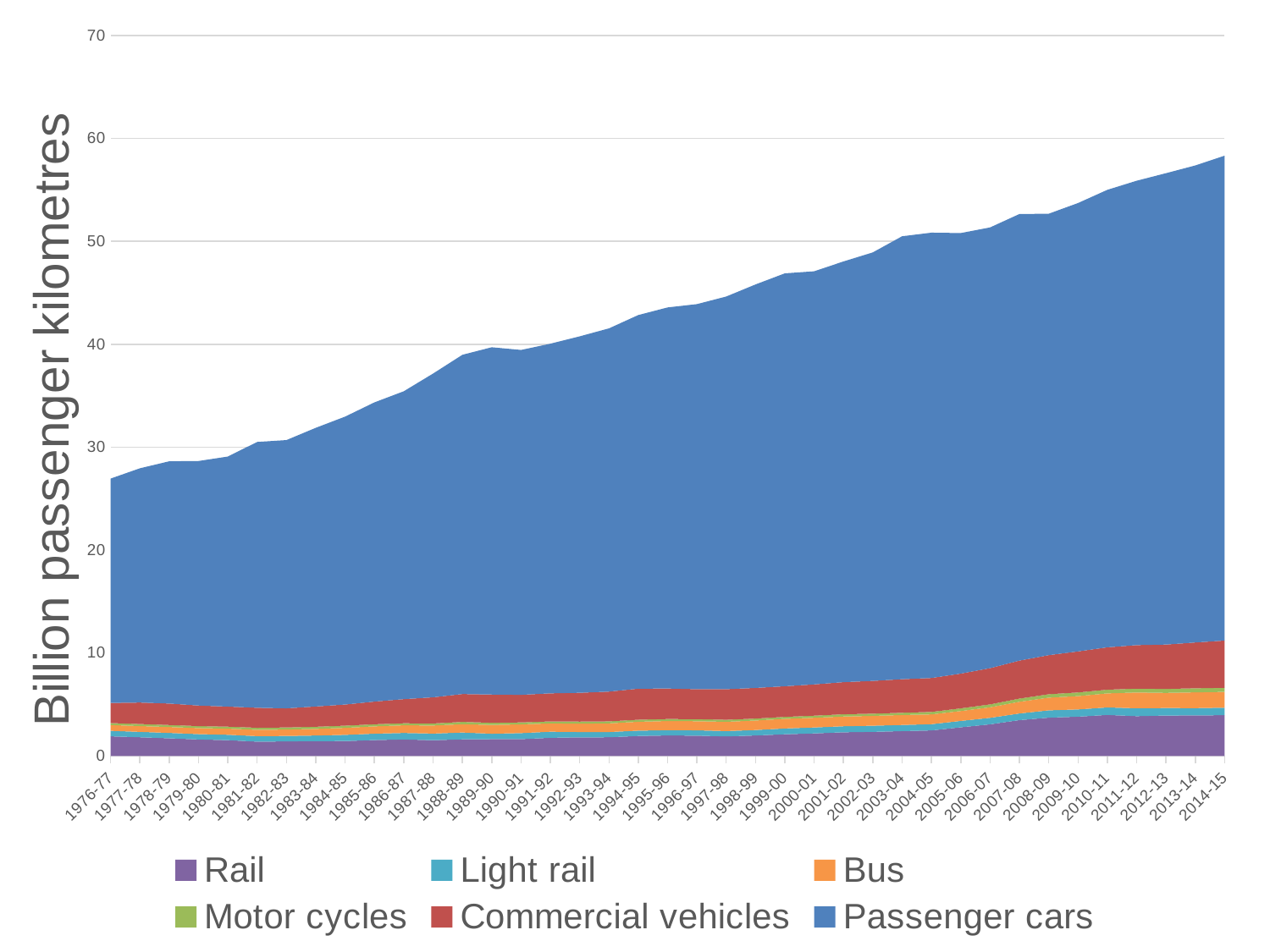
Which series is shown in blue in the legend? Passenger cars What is the label on the vertical axis? Billion passenger kilometres Which is larger, the stacked total for 2014-15 or for 1976-77? 2014-15 How many series does the legend list? 6 How many years are shown along the x axis? 39 What is the first year shown on the x axis? 1976-77 Is the stacked total for 1995-96 greater or less than 40? greater Which series accounts for the largest share of the stacked total across the years? Passenger cars Does the total of all series rise or fall from 1976-77 to 2014-15? Rise Is the stacked total for 2014-15 greater or less than 50? greater What kind of chart is shown on the slide? Stacked area chart Is the stacked total for 1976-77 greater or less than 30? less